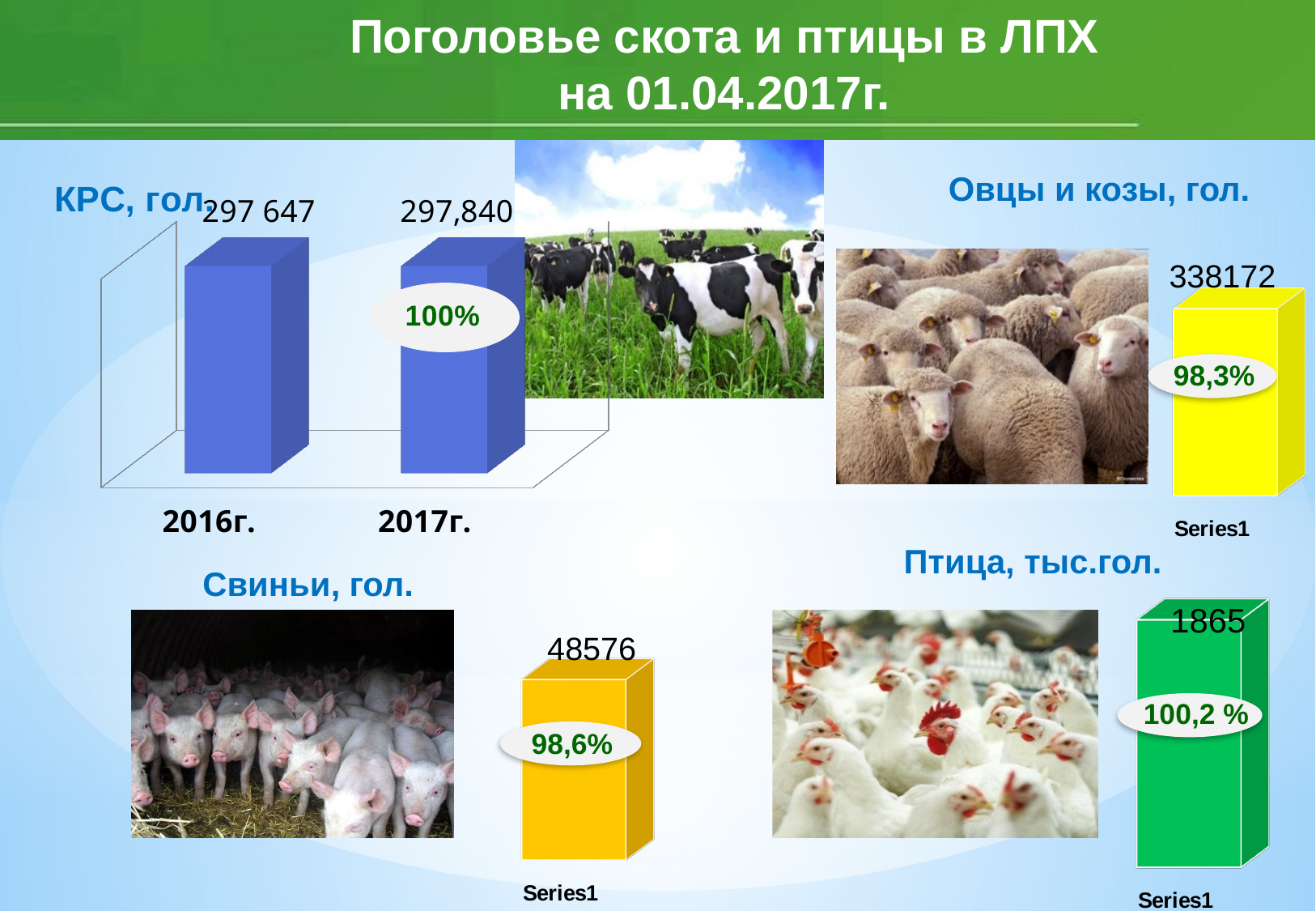
How many charts are shown on the slide? 4 In the 'Овцы и козы, гол.' chart, what value is printed above the bar? 338172 In the 'Овцы и козы, гол.' chart, what percentage is shown in the oval on the bar? 98,3% In the 'КРС, гол.' chart, what kind of chart is shown? bar chart In the 'Свиньи, гол.' chart, what value is printed above the bar? 48576 In the 'КРС, гол.' chart, how many bars are plotted? 2 In the 'КРС, гол.' chart, what is the value for 2017г.? 297,840 In the 'Птица, тыс.гол.' chart, what value is printed on the bar? 1865 In the 'КРС, гол.' chart, what percentage is shown in the oval on the 2017г. bar? 100% In the 'КРС, гол.' chart, what is the value for 2016г.? 297 647 In the 'Свиньи, гол.' chart, how many bars are plotted? 1 In the 'Птица, тыс.гол.' chart, what is the category label shown under the bar? Series1